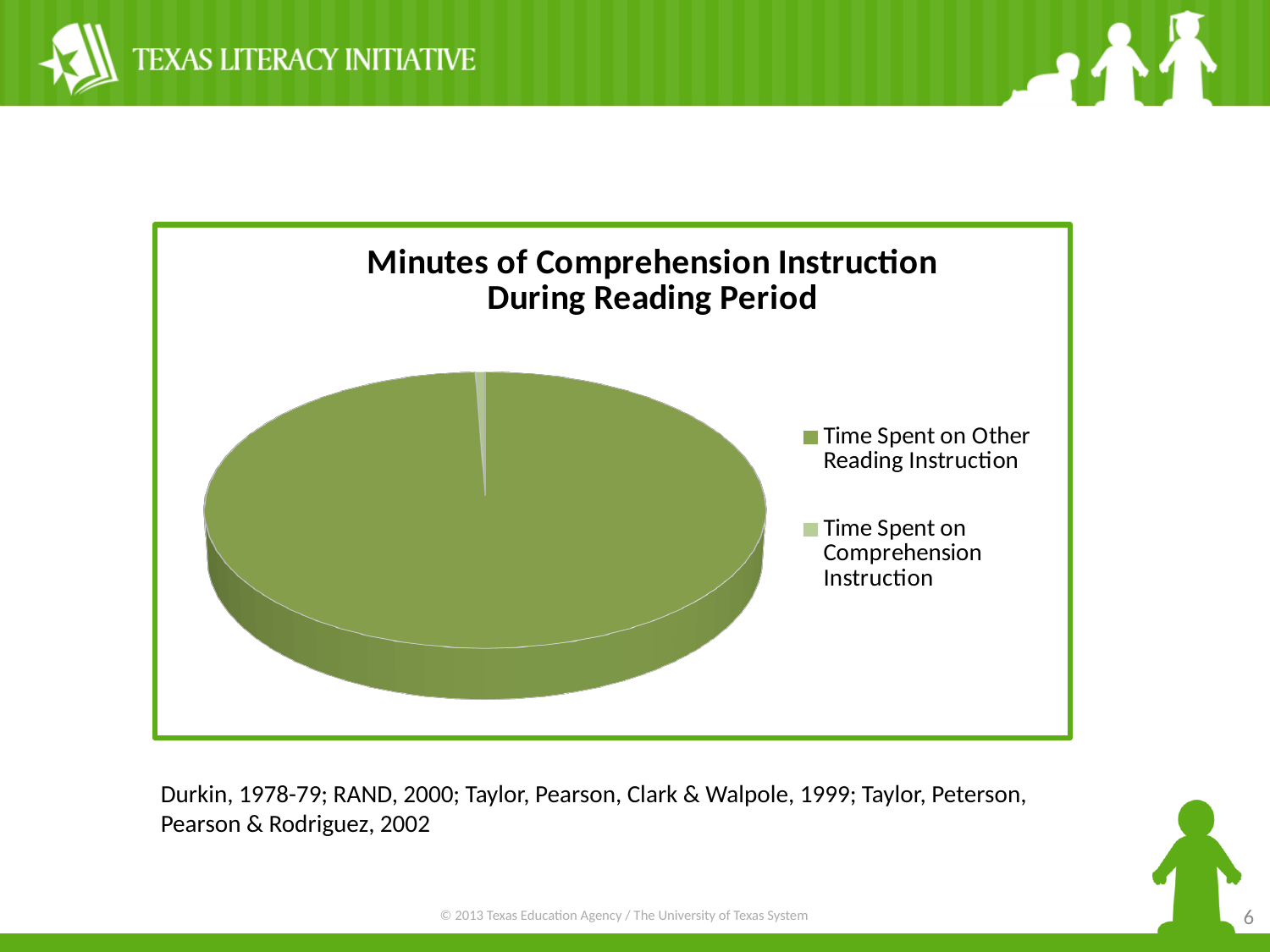
Which is larger: Time Spent on Other Reading Instruction or Time Spent on Comprehension Instruction? Time Spent on Other Reading Instruction Which category takes up the smallest share of the pie? Time Spent on Comprehension Instruction What are the two legend entries of the pie chart? Time Spent on Other Reading Instruction; Time Spent on Comprehension Instruction What kind of chart is shown on the slide? pie chart How many entries does the chart's legend list? 2 Which category takes up the largest share of the pie? Time Spent on Other Reading Instruction How many slices does the pie chart have? 2 What is the title of the chart? Minutes of Comprehension Instruction During Reading Period